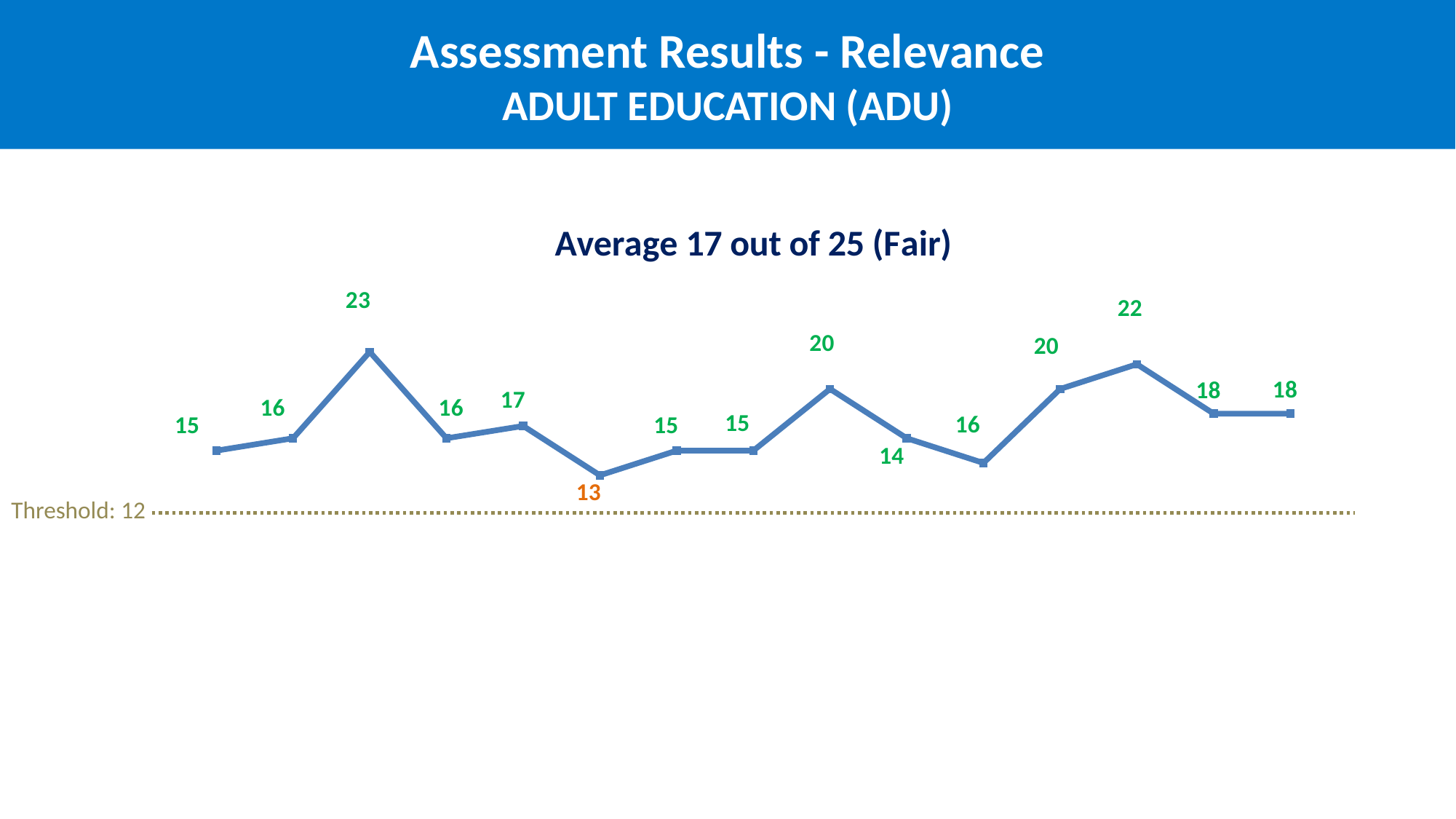
How many data points are plotted on the line? 15 What kind of chart is shown on the slide? line chart What is the lowest value plotted on the line? 13 What is the title shown above the chart? Average 17 out of 25 (Fair) What is the value of the last data point on the line? 18 What is the value of the third data point on the line? 23 Which is larger, the value of the third data point or the value of the thirteenth data point? the third data point (23) Does the line rise or fall between the fifth and sixth data points? fall What is the value of the first data point on the line? 15 What is the highest value plotted on the line? 23 What threshold value is marked by the dotted line? 12 What is the difference between the highest and lowest values on the line? 10